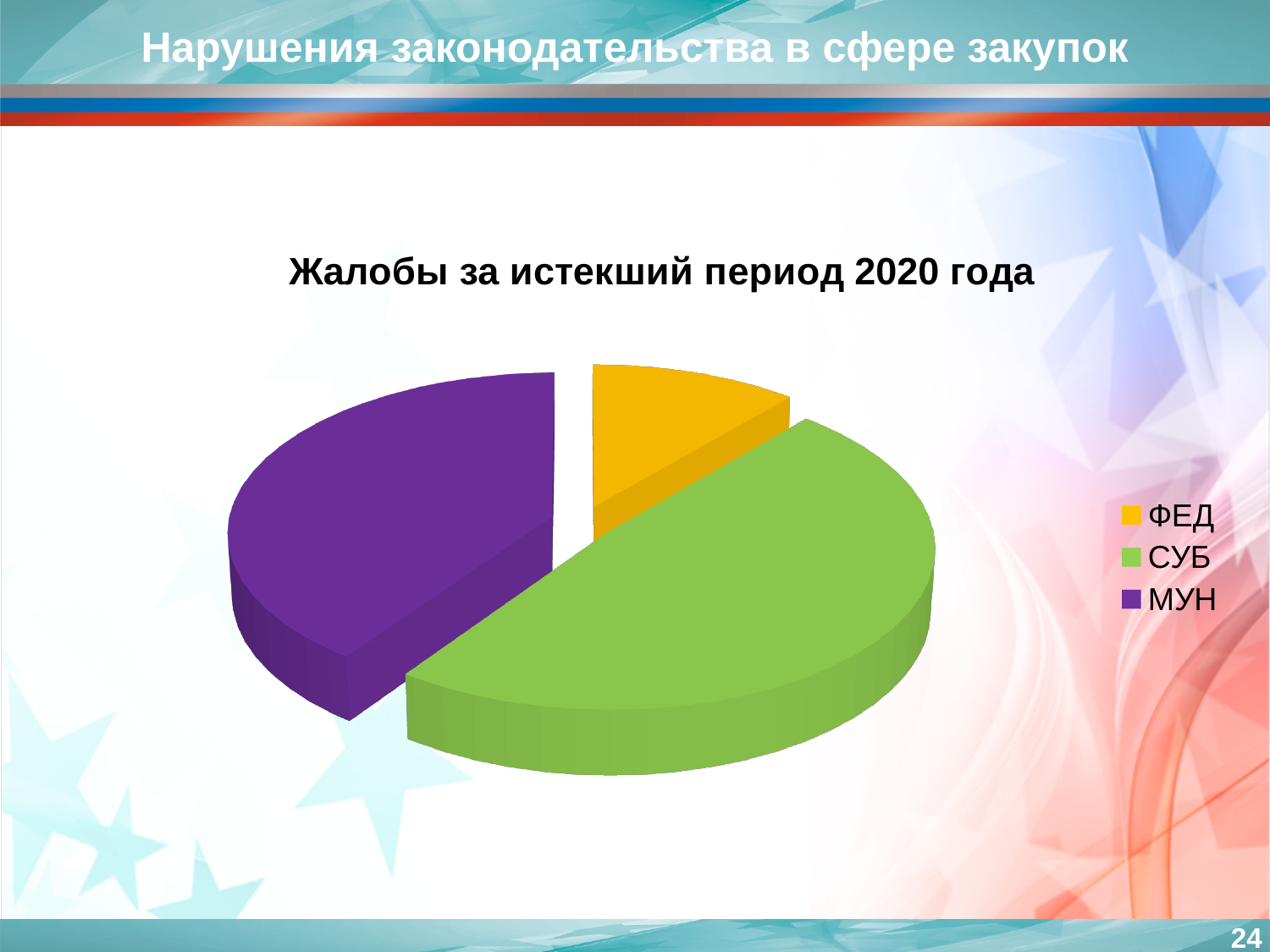
What colour is the СУБ slice in the pie chart? green Which category has the smallest slice of the pie? ФЕД What is the title of the chart? Жалобы за истекший период 2020 года Which category has the largest slice of the pie? СУБ Which slice is smaller, ФЕД or СУБ? ФЕД What kind of chart is shown on the slide? pie chart Which slice is larger, СУБ or МУН? СУБ Which slice is larger, МУН or ФЕД? МУН How many entries does the legend list? 3 How many slices does the pie chart have? 3